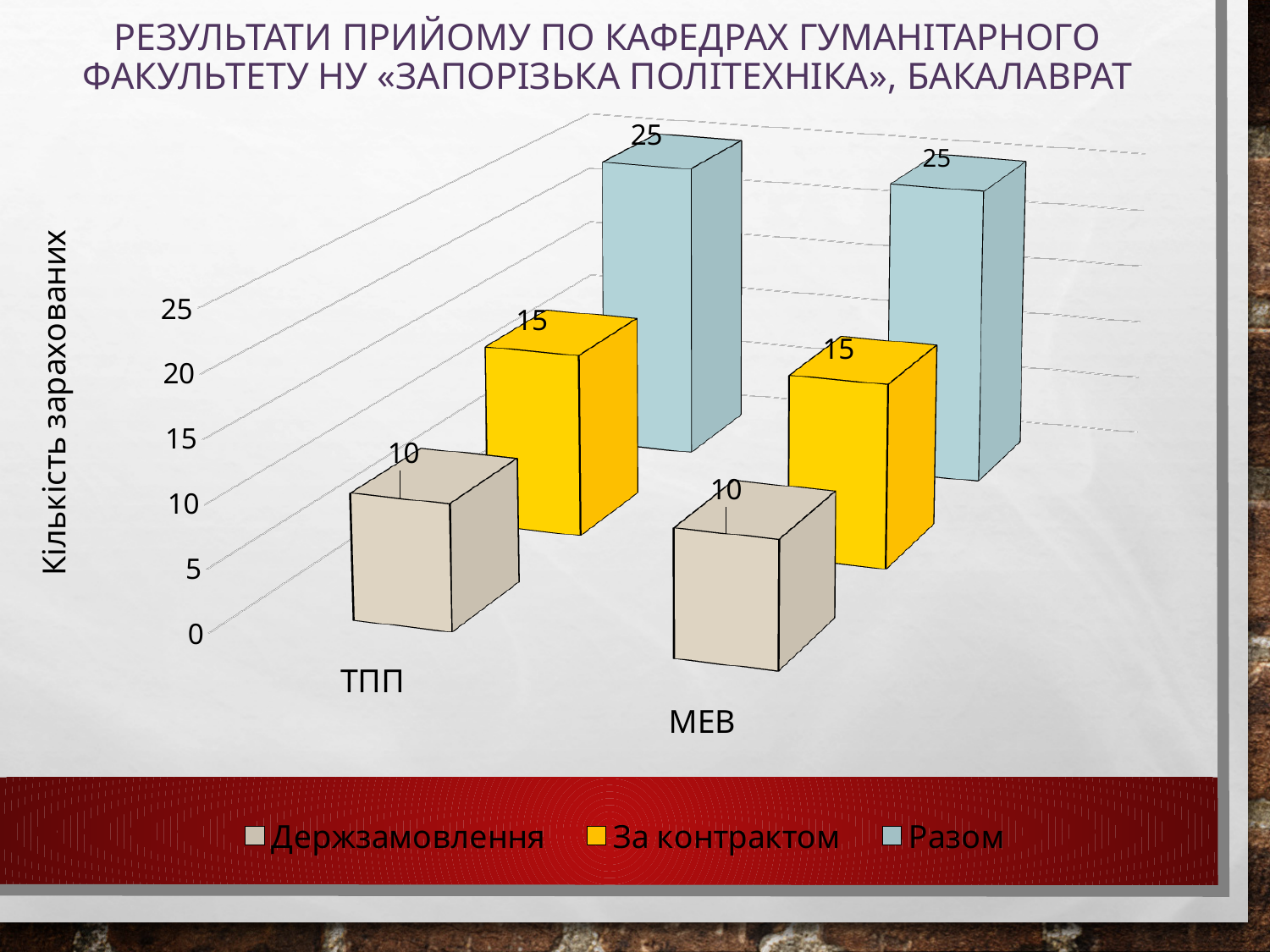
What is the value of Держзамовлення for ТПП? 10 What is the value of Разом for ТПП? 25 Which series has the lowest value for МЕВ? Держзамовлення How many series does the legend list? 3 What is the difference between Разом and За контрактом for МЕВ? 10 How many categories are shown on the x axis? 2 What is the label of the vertical axis? Кількість зарахованих Which series has the highest value for ТПП? Разом What kind of chart is shown on the slide? Bar chart What is the value of За контрактом for МЕВ? 15 What is the value of Разом for МЕВ? 25 Which is larger for ТПП: Держзамовлення or За контрактом? За контрактом